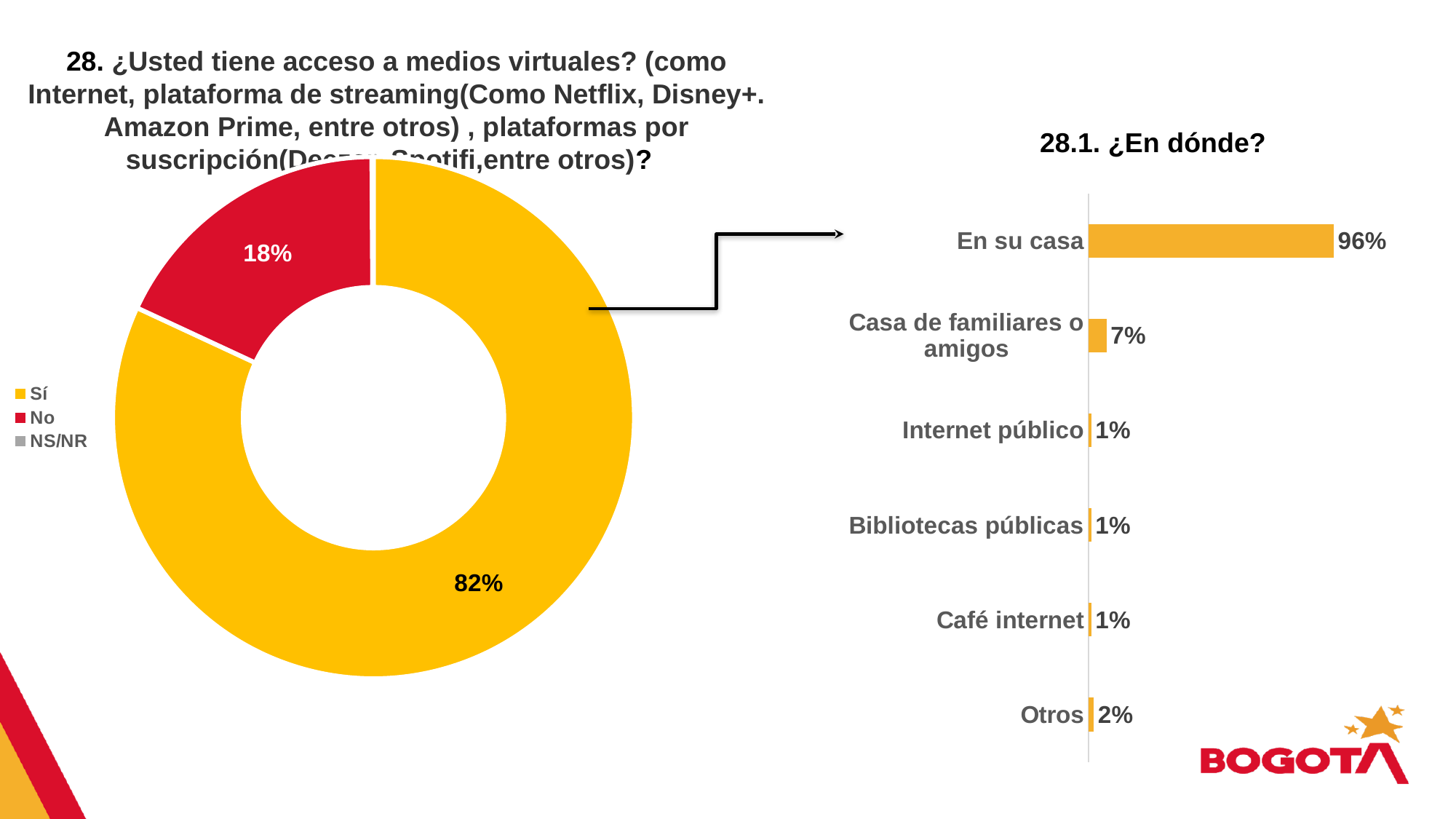
In the right chart "28.1. ¿En dónde?", what is the value for "En su casa"? 96% How many entries does the legend of the left chart (question 28) list? 3 What kind of chart is the left chart (question 28)? Doughnut (pie) chart In the right chart "28.1. ¿En dónde?", what is the value for "Casa de familiares o amigos"? 7% What kind of chart is the right chart "28.1. ¿En dónde?"? Bar chart In the right chart "28.1. ¿En dónde?", how many categories are shown? 6 In the right chart "28.1. ¿En dónde?", what is the value for "Otros"? 2% In the left chart (question 28), what percentage answered "No"? 18% In the right chart "28.1. ¿En dónde?", which category has the highest value? En su casa In the left chart (question 28), what percentage answered "Sí"? 82% In the left chart (question 28), what is the difference between the "Sí" and "No" shares? 64 percentage points In the right chart "28.1. ¿En dónde?", what is the difference between "En su casa" and "Casa de familiares o amigos"? 89 percentage points